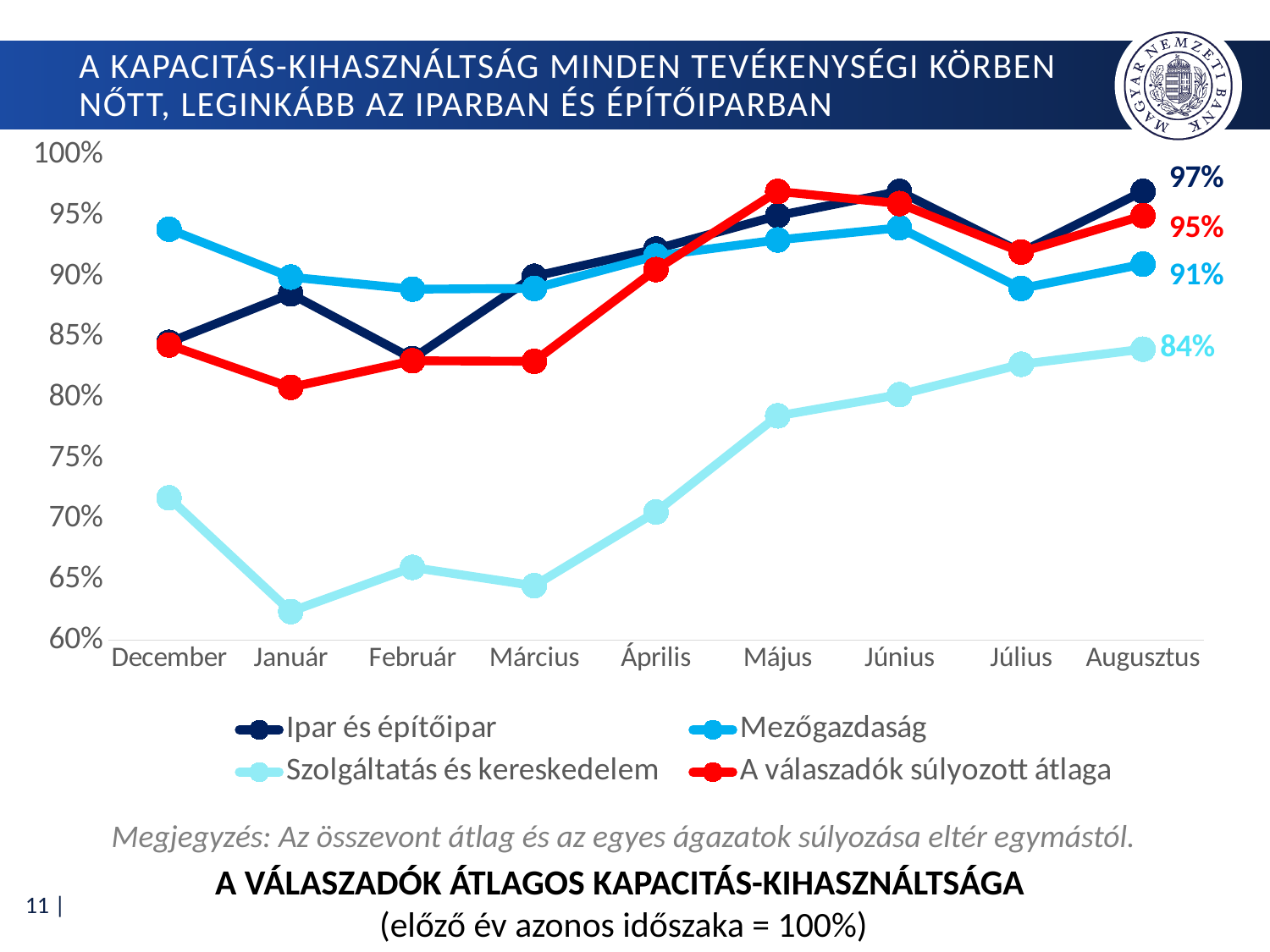
How many series does the legend list? 4 What is the value for A válaszadók súlyozott átlaga in Augusztus? 95% What is the difference between the Augusztus values of Ipar és építőipar and Szolgáltatás és kereskedelem? 13 percentage points Which series has the lowest value in Augusztus? Szolgáltatás és kereskedelem What kind of chart is shown on the slide? line chart Is the value for Szolgáltatás és kereskedelem in Január greater or less than 65%? less Which series has the highest value in Augusztus? Ipar és építőipar What is the value for Mezőgazdaság in Augusztus? 91% What is the value for Szolgáltatás és kereskedelem in Augusztus? 84% How many months are shown on the x axis? 9 What is the value for Ipar és építőipar in Augusztus? 97% In Augusztus, which is larger: A válaszadók súlyozott átlaga or Mezőgazdaság? A válaszadók súlyozott átlaga